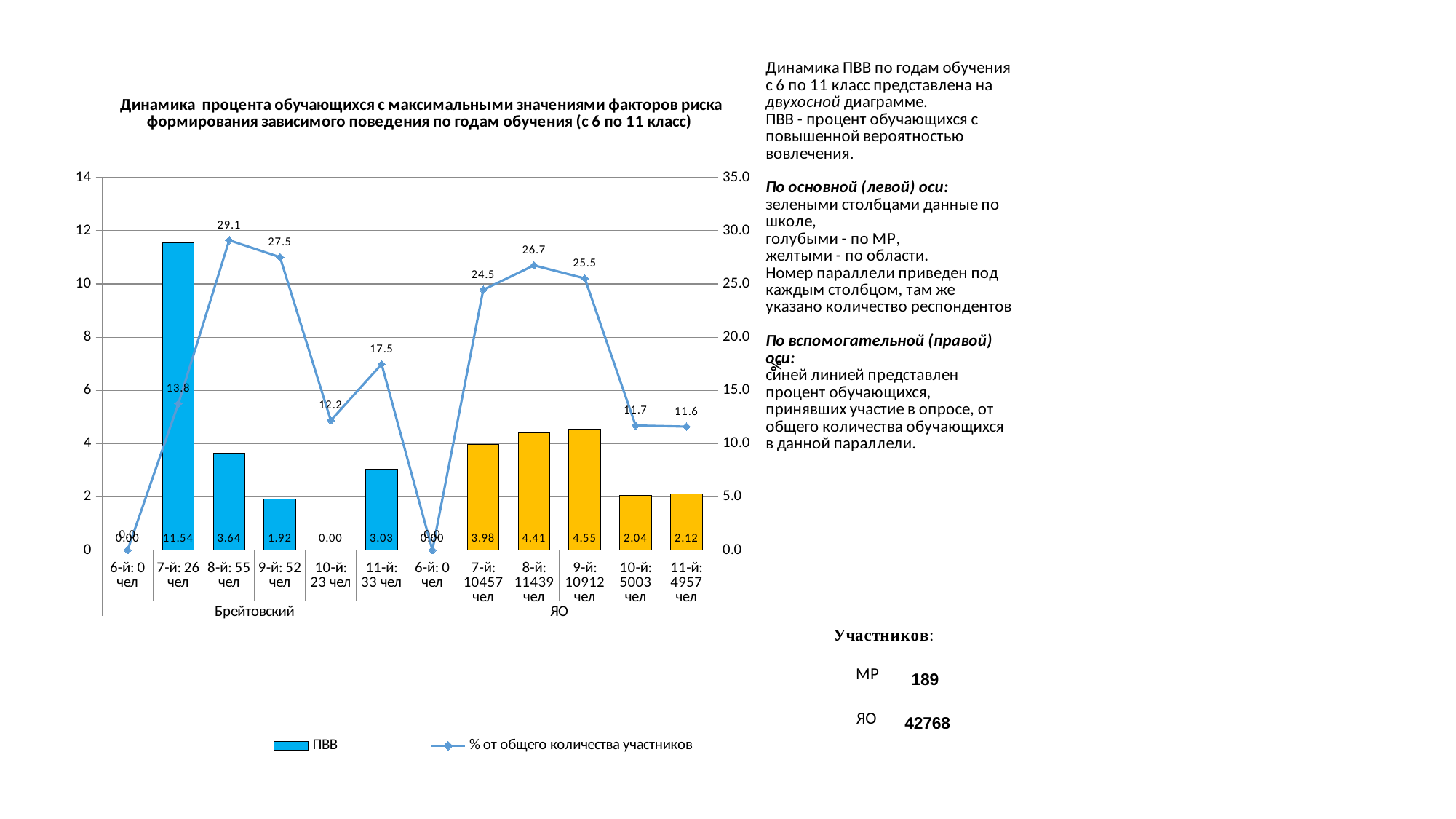
How many categories are shown along the x axis? 12 What kind of chart is shown on the slide? Combined bar and line chart with two axes What is the ПВВ value for the 7-й class in the Брейтовский group? 11.54 Which is larger: the '% от общего количества участников' value for the 9-й class in Брейтовский or for the 9-й class in ЯО? 9-й class in Брейтовский (27.5) How many series does the legend list? 2 What is the '% от общего количества участников' value for the 10-й class in the ЯО group? 11.7 Which class in the ЯО group has the lowest non-zero ПВВ value? 10-й: 5003 чел What is the ПВВ value for the 9-й class in the ЯО group? 4.55 Which category has the highest ПВВ bar? 7-й: 26 чел (Брейтовский) What is the maximum value shown on the right (secondary) axis? 35.0 What is the difference between the ПВВ values for the 8-й class in Брейтовский and the 8-й class in ЯО? 0.77 What is the '% от общего количества участников' value for the 8-й class in the Брейтовский group? 29.1